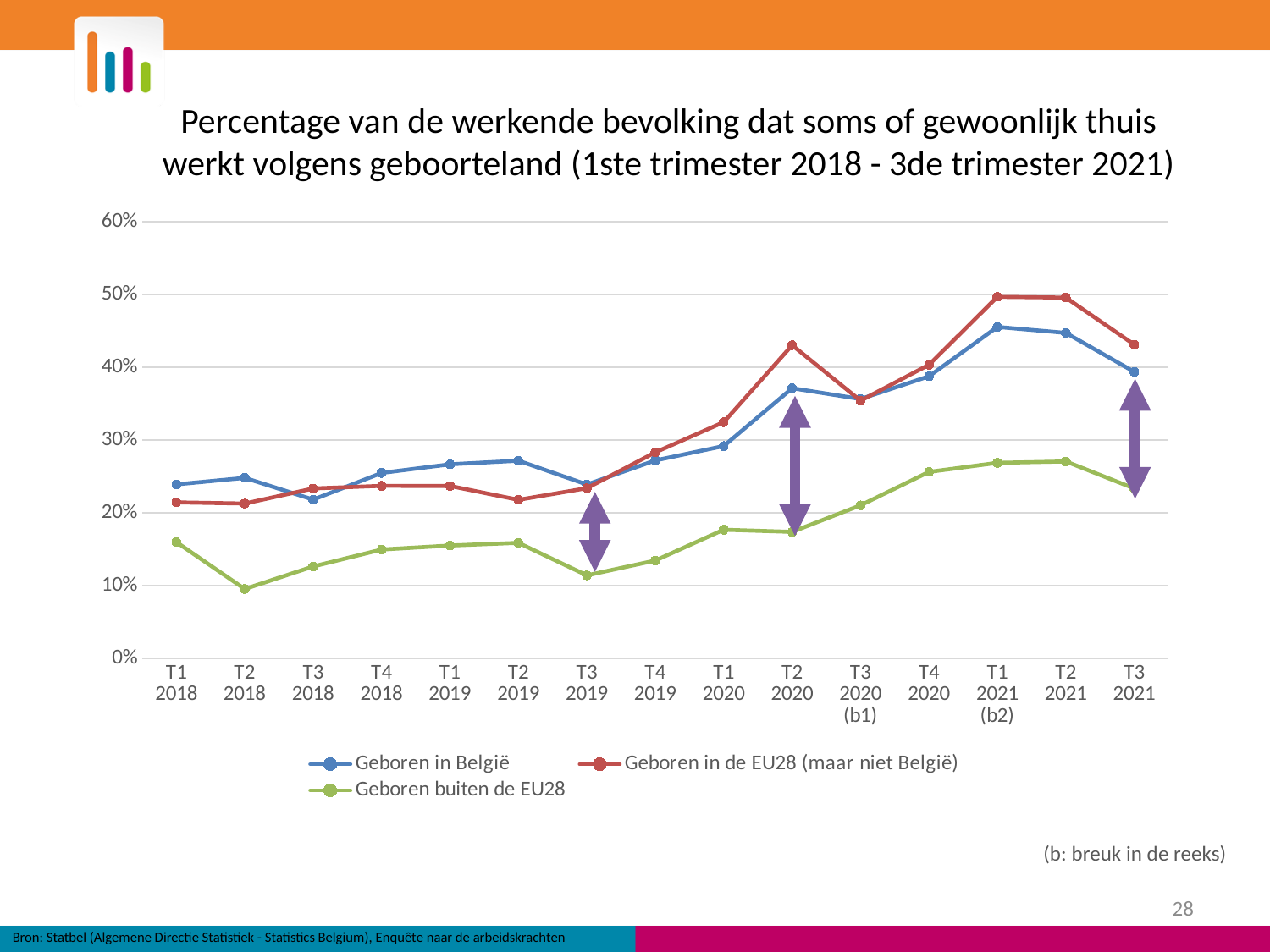
What colour is the line for 'Geboren buiten de EU28'? green Is the value for 'Geboren in de EU28 (maar niet België)' in T2 2020 greater or less than 40%? greater How many series does the legend list? 3 In T2 2020, which series has the higher value: 'Geboren in België' or 'Geboren in de EU28 (maar niet België)'? Geboren in de EU28 (maar niet België) In which quarter is the value for 'Geboren buiten de EU28' lowest? T2 2018 Which series has the lowest value in every quarter shown? Geboren buiten de EU28 How many quarters are plotted along the x axis? 15 Does the value for 'Geboren buiten de EU28' rise or fall from T3 2019 to T2 2021? rise Is the value for 'Geboren in België' in T1 2021 (b2) greater or less than 40%? greater Is the value for 'Geboren buiten de EU28' in T3 2021 greater or less than 20%? greater What kind of chart is shown on the slide? line chart